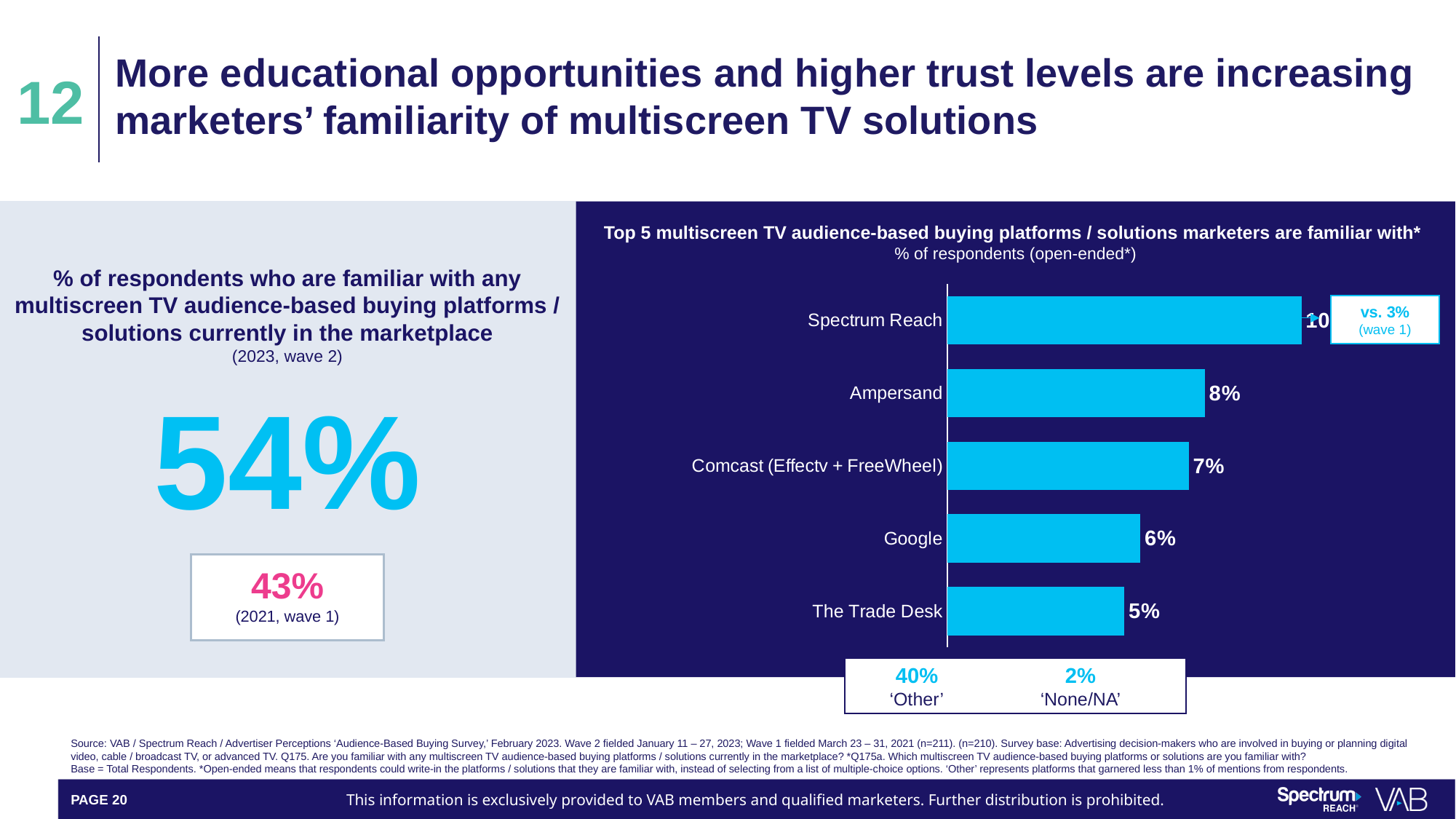
What is the difference between the values for Ampersand and The Trade Desk? 3% What is the value for The Trade Desk? 5% What was Spectrum Reach's value in wave 1, according to the callout next to its bar? 3% What kind of chart is shown on the slide? bar chart What is the value for Comcast (Effectv + FreeWheel)? 7% What percentage of respondents are familiar with Ampersand? 8% How many platforms / solutions are plotted in the bar chart? 5 What is the value for Google? 6% Which has a larger value, Google or Comcast (Effectv + FreeWheel)? Comcast (Effectv + FreeWheel) Which of the five platforms has the lowest value? The Trade Desk Do the values rise or fall going from the top bar to the bottom bar? fall Which platform has the highest share of respondents familiar with it? Spectrum Reach